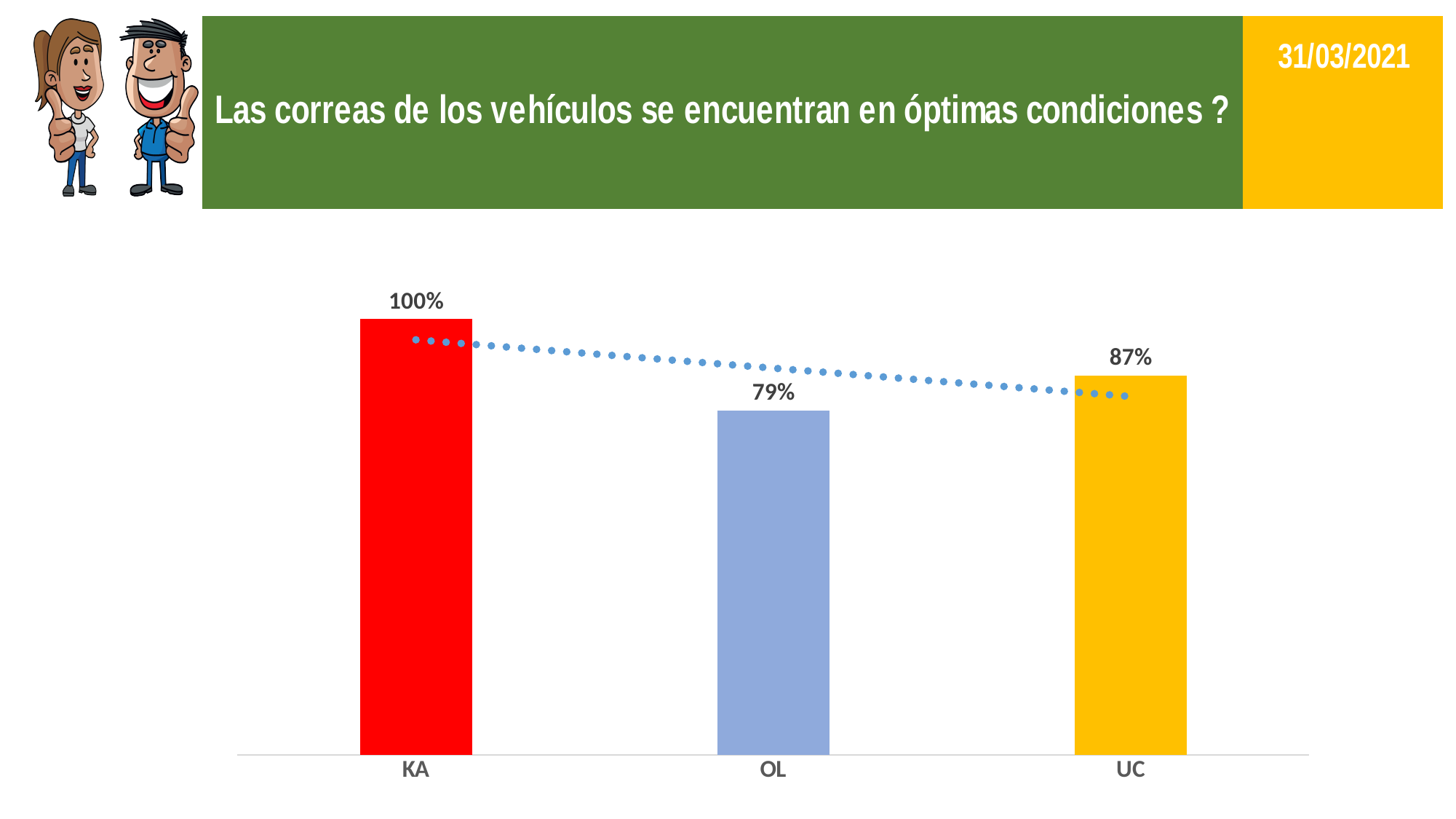
What is the value for UC? 87% What is the value for OL? 79% What is the date shown in the top right corner of the slide? 31/03/2021 Which is larger, the value for OL or the value for UC? UC What colour is the bar for KA? red What is the value for KA? 100% How many categories are shown on the x axis? 3 What is the difference between the values for UC and OL? 8% Which category has the lowest value? OL What kind of chart is shown on the slide? bar chart What is the difference between the values for KA and OL? 21% Which category has the highest value? KA